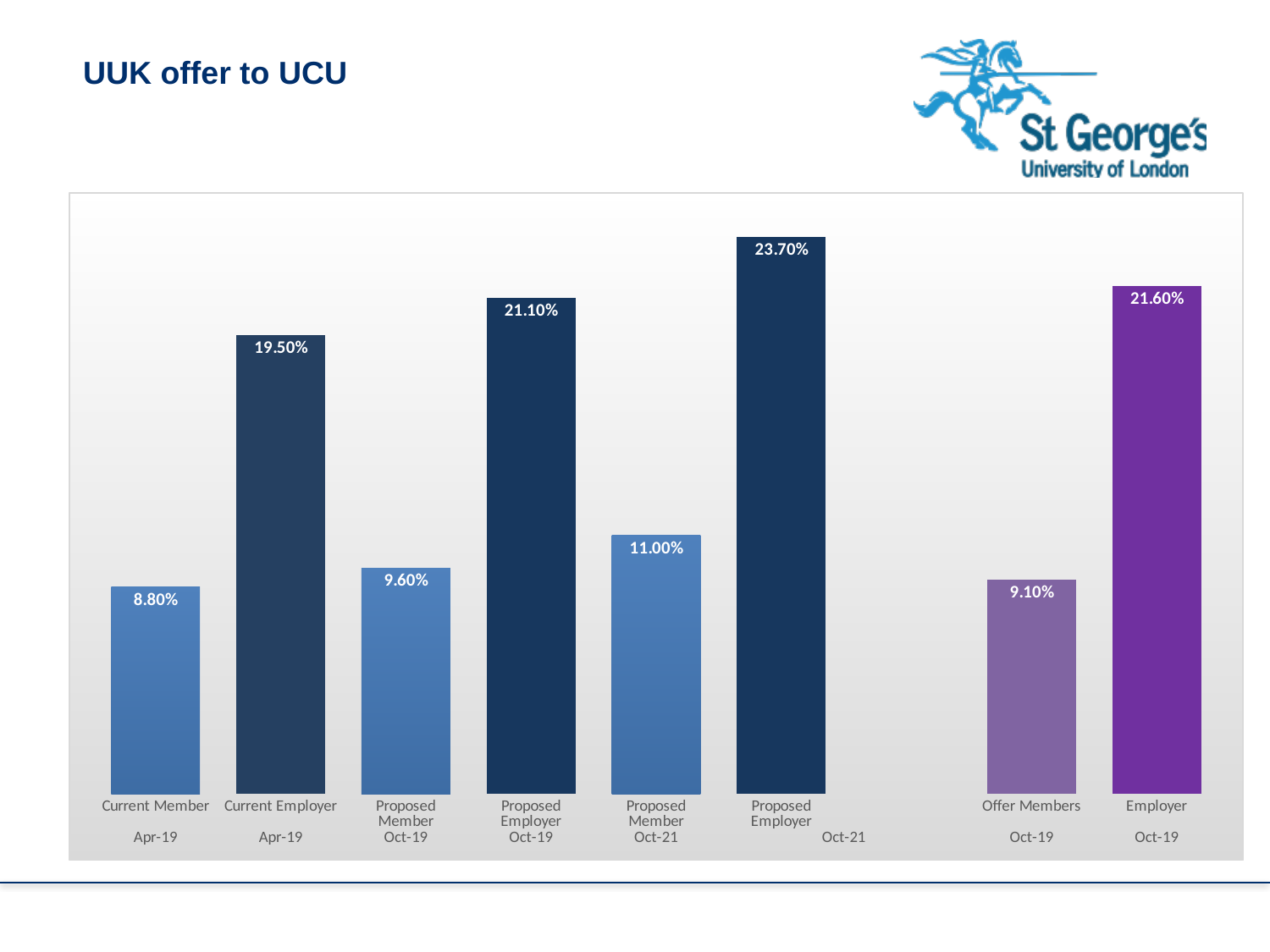
What kind of chart is shown on the slide? Bar chart What is the value for Employer Oct-19 (the purple bar)? 21.60% What is the difference between Proposed Employer Oct-19 and Current Employer Apr-19? 1.60% What is the title of the slide containing the chart? UUK offer to UCU What is the difference between Proposed Member Oct-21 and Proposed Member Oct-19? 1.40% What is the value for Current Member Apr-19? 8.80% Which category has the highest value? Proposed Employer Oct-21 What is the value for Proposed Employer Oct-21? 23.70% Which is larger, Employer Oct-19 or Proposed Employer Oct-19? Employer Oct-19 What is the value for Offer Members Oct-19? 9.10% How many bars are plotted on the chart? 8 Which category has the lowest value? Current Member Apr-19